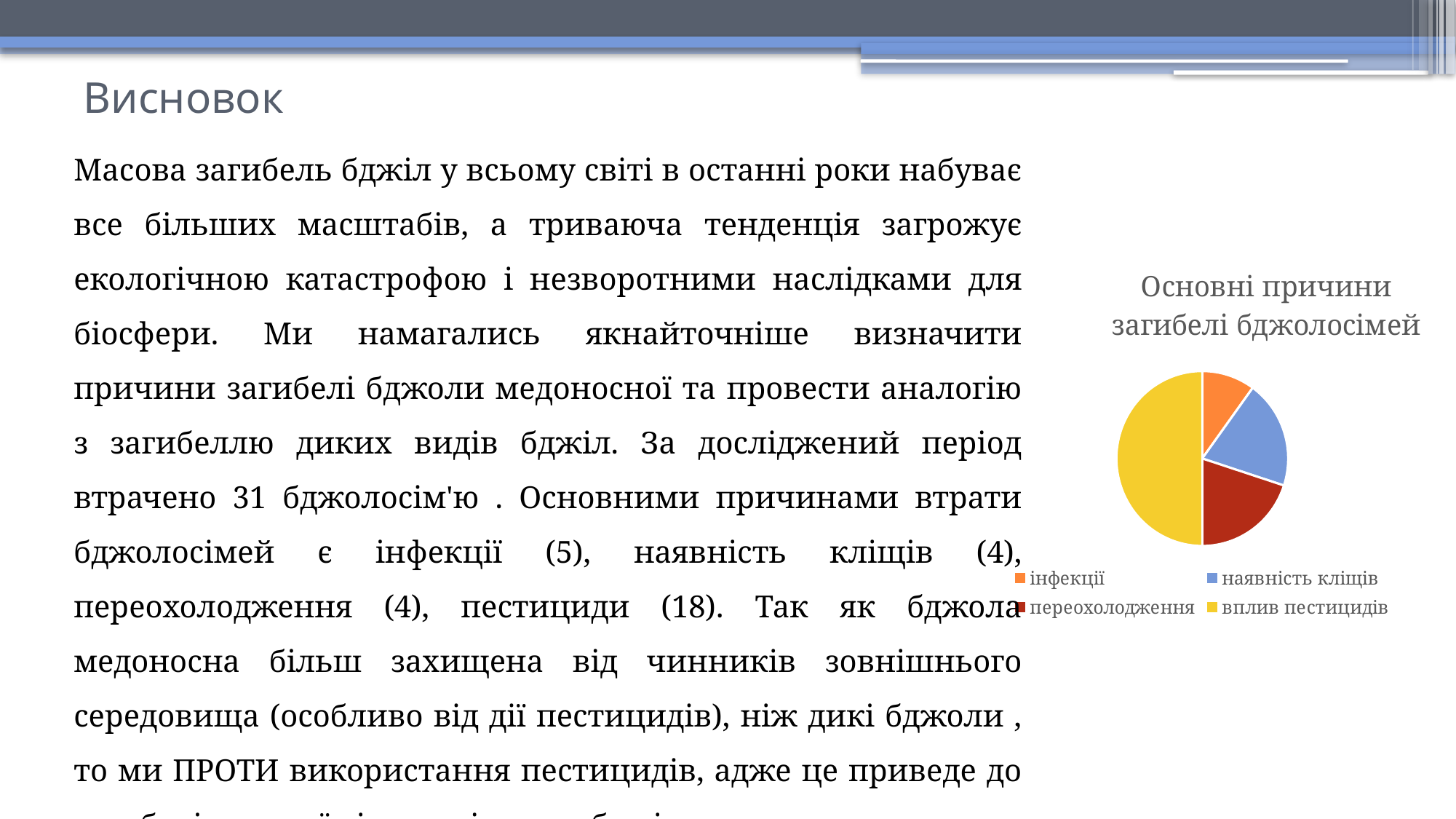
Which slice is larger: вплив пестицидів or інфекції? вплив пестицидів What colour represents вплив пестицидів in the pie chart? yellow Which slice is larger: наявність кліщів or вплив пестицидів? вплив пестицидів Which cause has the largest slice in the pie chart? вплив пестицидів Which slice is larger: переохолодження or вплив пестицидів? вплив пестицидів What is the title of the chart? Основні причини загибелі бджолосімей Which cause has the smallest slice in the pie chart? інфекції How many entries does the chart legend list? 4 What kind of chart is shown on the slide? pie chart How many slices does the pie chart have? 4